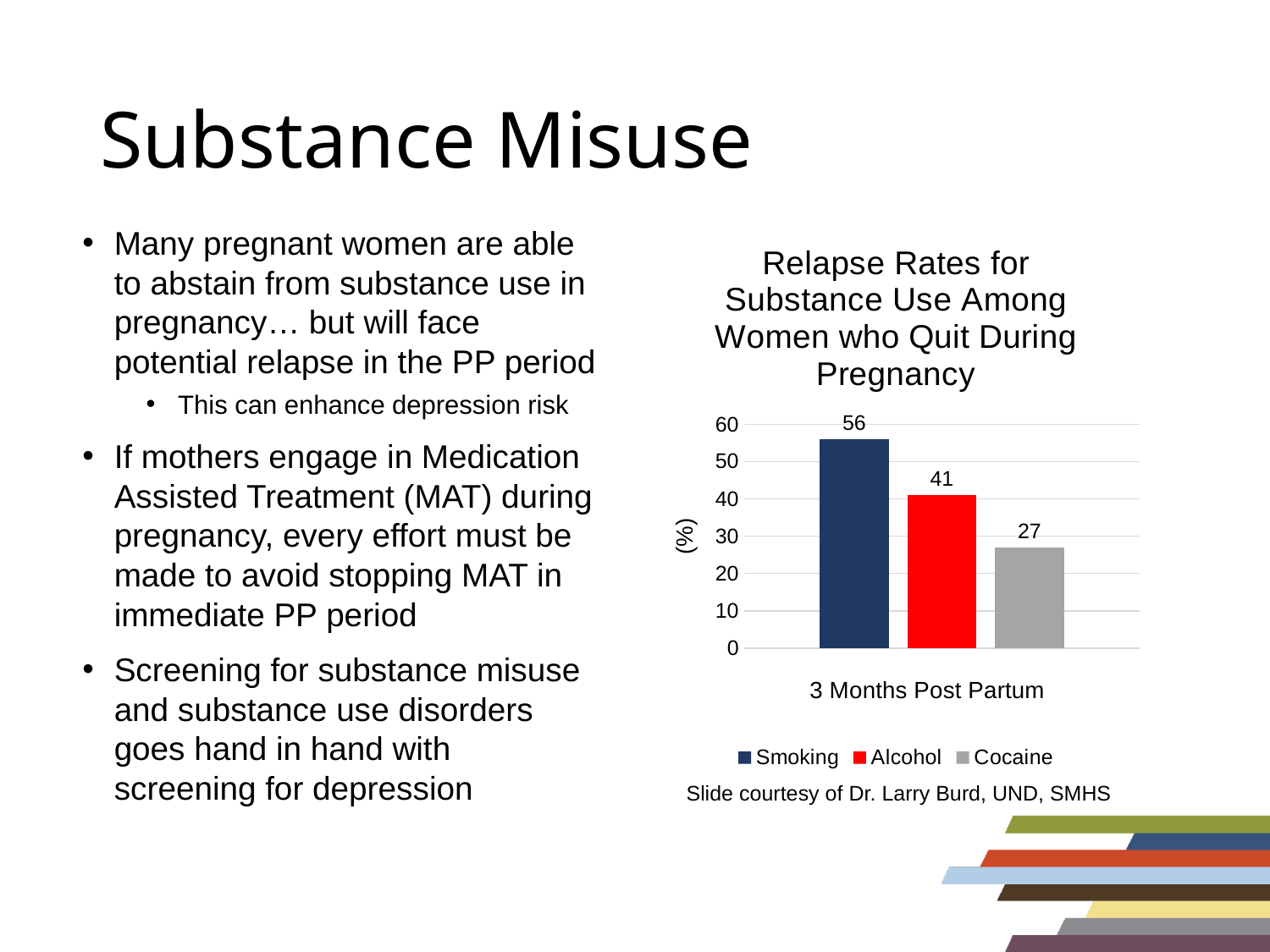
What is the title of the chart? Relapse Rates for Substance Use Among Women who Quit During Pregnancy Is the relapse rate for Alcohol greater or less than 50? less How many series does the legend list? 3 Which has a higher relapse rate, Alcohol or Cocaine? Alcohol What is the relapse rate for Alcohol at 3 Months Post Partum? 41 Which substance has the highest relapse rate? Smoking What is the relapse rate for Cocaine at 3 Months Post Partum? 27 What kind of chart is shown on the slide? Bar chart What is the difference between the relapse rates for Smoking and Alcohol? 15 What is the relapse rate for Smoking at 3 Months Post Partum? 56 What is the difference between the relapse rates for Smoking and Cocaine? 29 Which substance has the lowest relapse rate? Cocaine